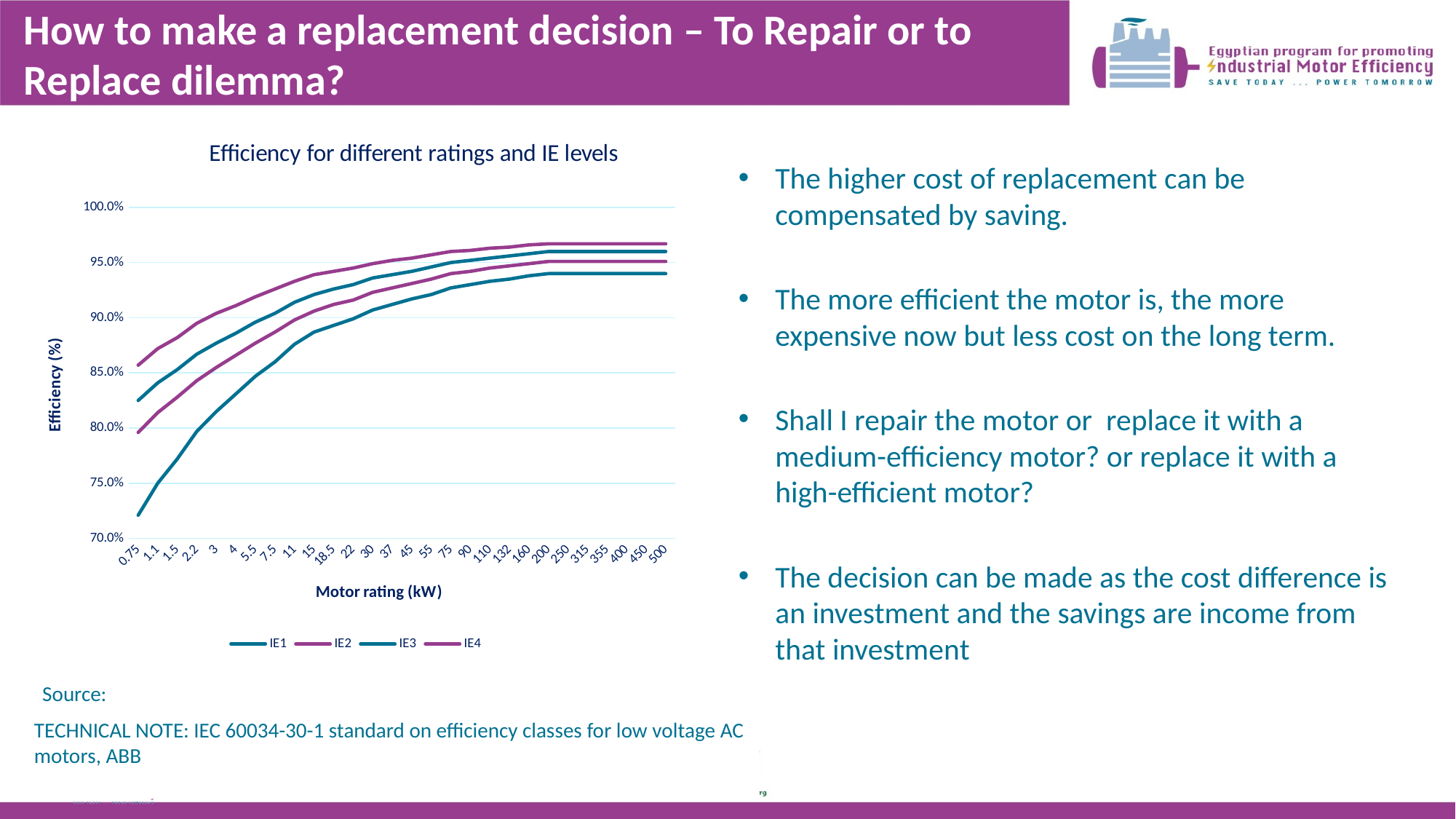
Is the efficiency of IE1 at 500 kW greater or less than 95.0%? less At 0.75 kW, which series has the higher efficiency, IE4 or IE1? IE4 Which series has the lowest efficiency at 0.75 kW? IE1 Is the efficiency of IE4 at 500 kW greater or less than 95.0%? greater What kind of chart is shown on the slide? Line chart Is the efficiency of IE1 at 0.75 kW greater or less than 75.0%? less How many series does the legend list? 4 Do the efficiency values rise or fall as the motor rating increases along the x axis? Rise What is the title of the chart? Efficiency for different ratings and IE levels What is the label of the x axis? Motor rating (kW) How many motor rating categories are shown on the x axis? 28 Which series has the highest efficiency at 500 kW? IE4